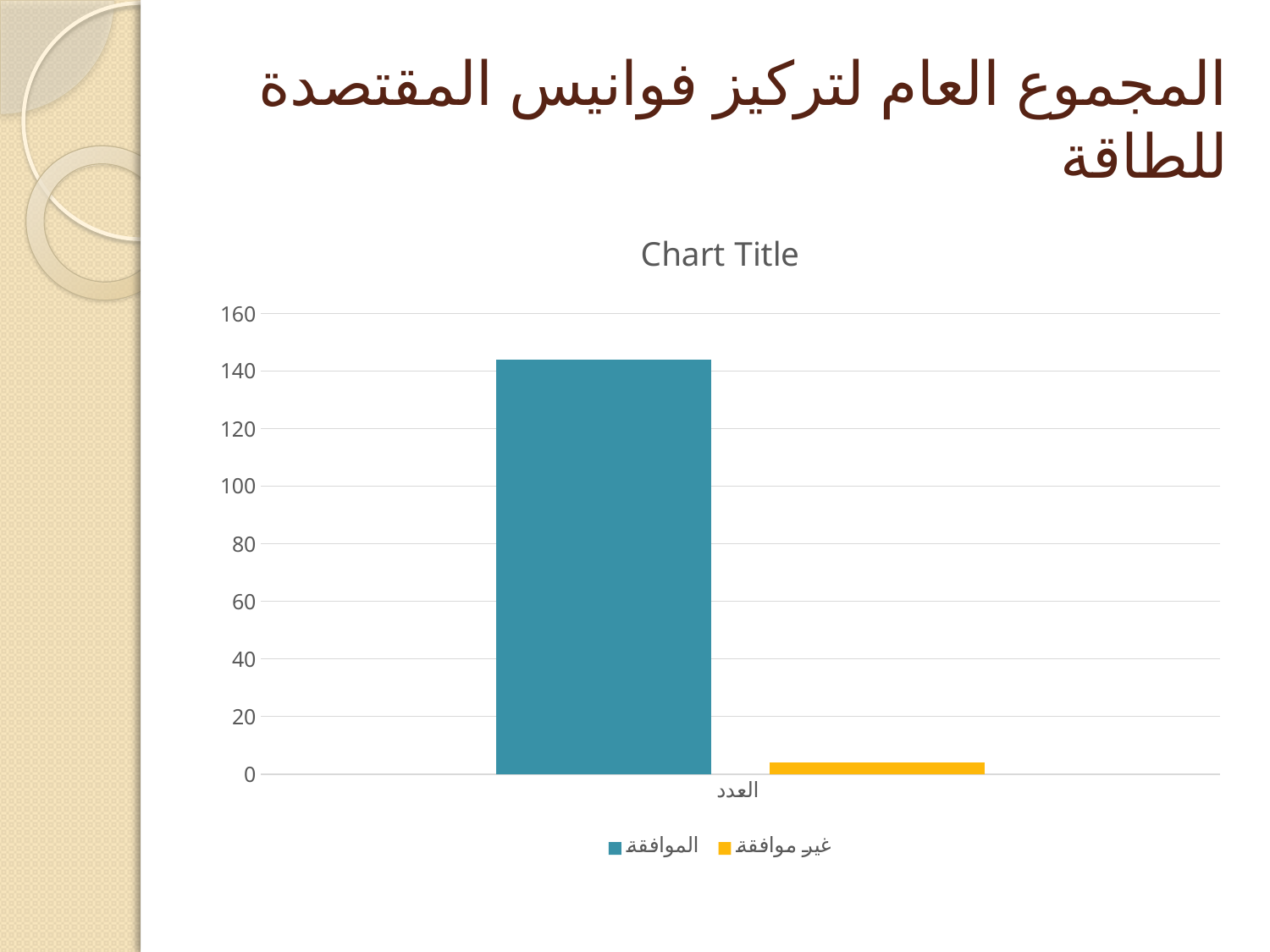
Which series has the highest value? الموافقة Is the value for غير موافقة greater or less than 20? less How many series does the legend list? 2 Which series has the lowest value? غير موافقة Is the value for الموافقة greater or less than 160? less What is the title shown above the chart? Chart Title What kind of chart is shown on the slide? bar chart Is the value for الموافقة greater or less than 120? greater Which is larger, the value for الموافقة or the value for غير موافقة? الموافقة What colour is the bar for غير موافقة? yellow How many categories are shown on the x axis? 1